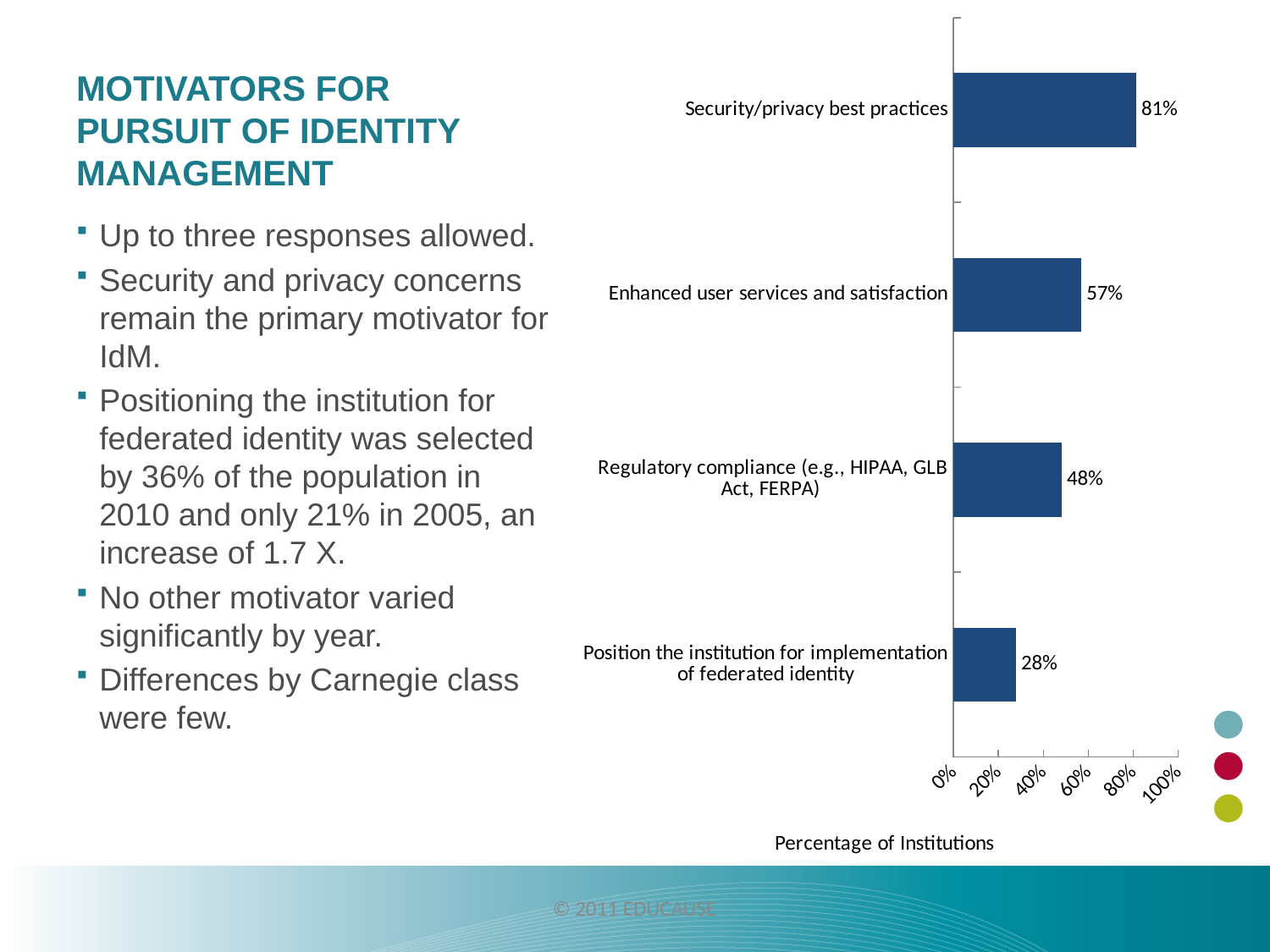
What is the difference between the values for Security/privacy best practices and Enhanced user services and satisfaction? 24% What percentage is shown for Regulatory compliance (e.g., HIPAA, GLB Act, FERPA)? 48% What percentage of institutions selected Security/privacy best practices as a motivator? 81% Which motivator has the highest percentage of institutions? Security/privacy best practices What is the difference between Regulatory compliance and Position the institution for implementation of federated identity? 20% How many motivator categories are shown in the chart? 4 Which is larger: Enhanced user services and satisfaction or Regulatory compliance? Enhanced user services and satisfaction Which motivator has the lowest percentage of institutions? Position the institution for implementation of federated identity What is the label of the horizontal axis of the chart? Percentage of Institutions What is the value for Position the institution for implementation of federated identity? 28% What is the value for Enhanced user services and satisfaction? 57% What kind of chart is shown on the slide? Bar chart